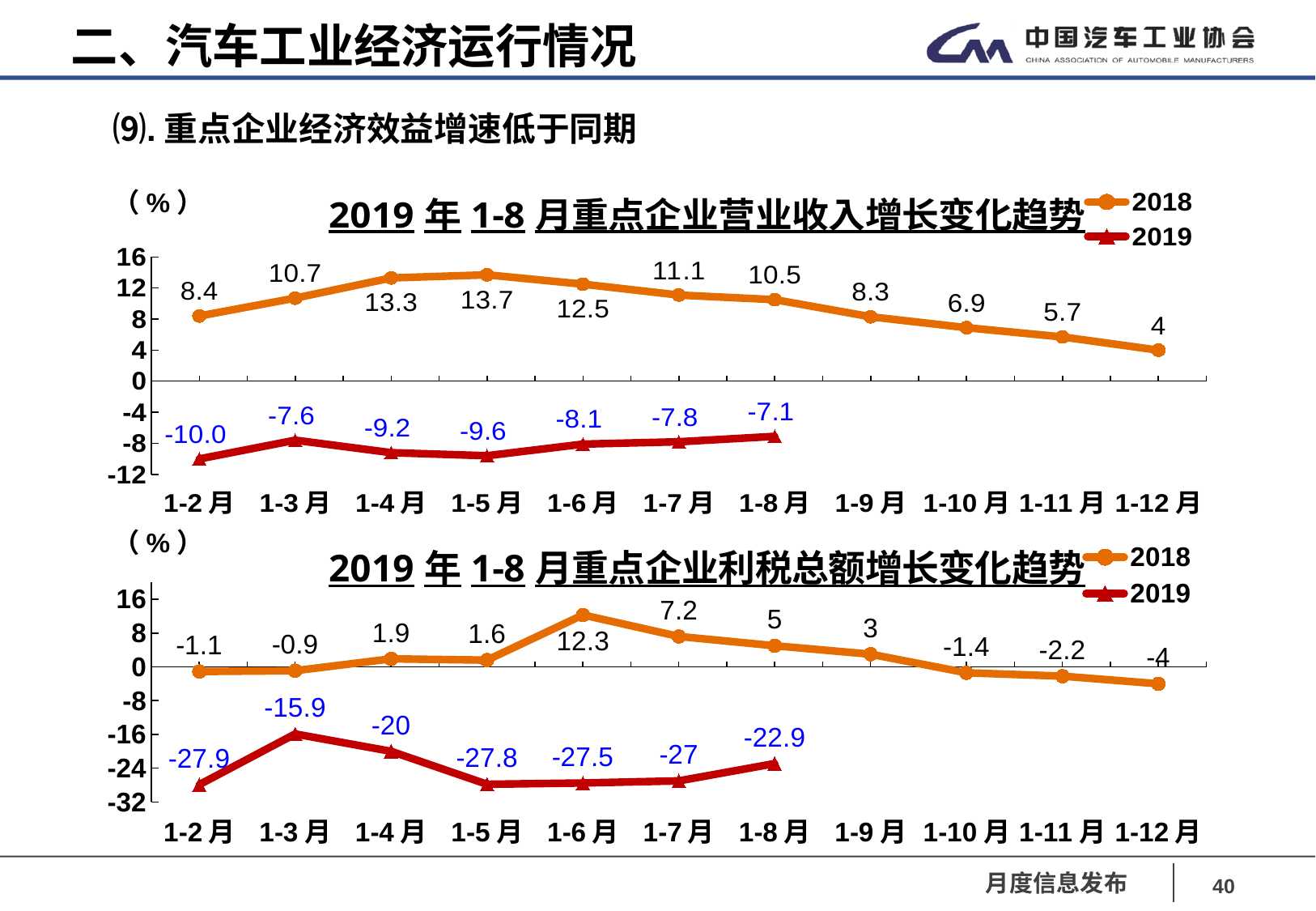
In the bottom chart (利税总额增长变化趋势), how many series does the legend list? 2 In the bottom chart (利税总额增长变化趋势), which period has the lowest 2019 value? 1-2月 In the bottom chart (利税总额增长变化趋势), what is the 2019 value for 1-3月? -15.9 What type of chart is the top chart (营业收入增长变化趋势)? Line chart In the top chart (营业收入增长变化趋势), what is the 2018 value for 1-5月? 13.7 In the top chart (营业收入增长变化趋势), which period has the highest 2018 value? 1-5月 In the bottom chart (利税总额增长变化趋势), is the 2018 value for 1-7月 larger or the 2018 value for 1-9月? 1-7月 In the bottom chart (利税总额增长变化趋势), what is the 2018 value for 1-6月? 12.3 In the top chart (营业收入增长变化趋势), what is the 2019 value for 1-8月? -7.1 In the top chart (营业收入增长变化趋势), which period has the lowest 2019 value? 1-2月 In the top chart (营业收入增长变化趋势), what is the difference between the 2018 and 2019 values for 1-8月? 17.6 In the top chart (营业收入增长变化趋势), how many data points does the 2019 series have? 7